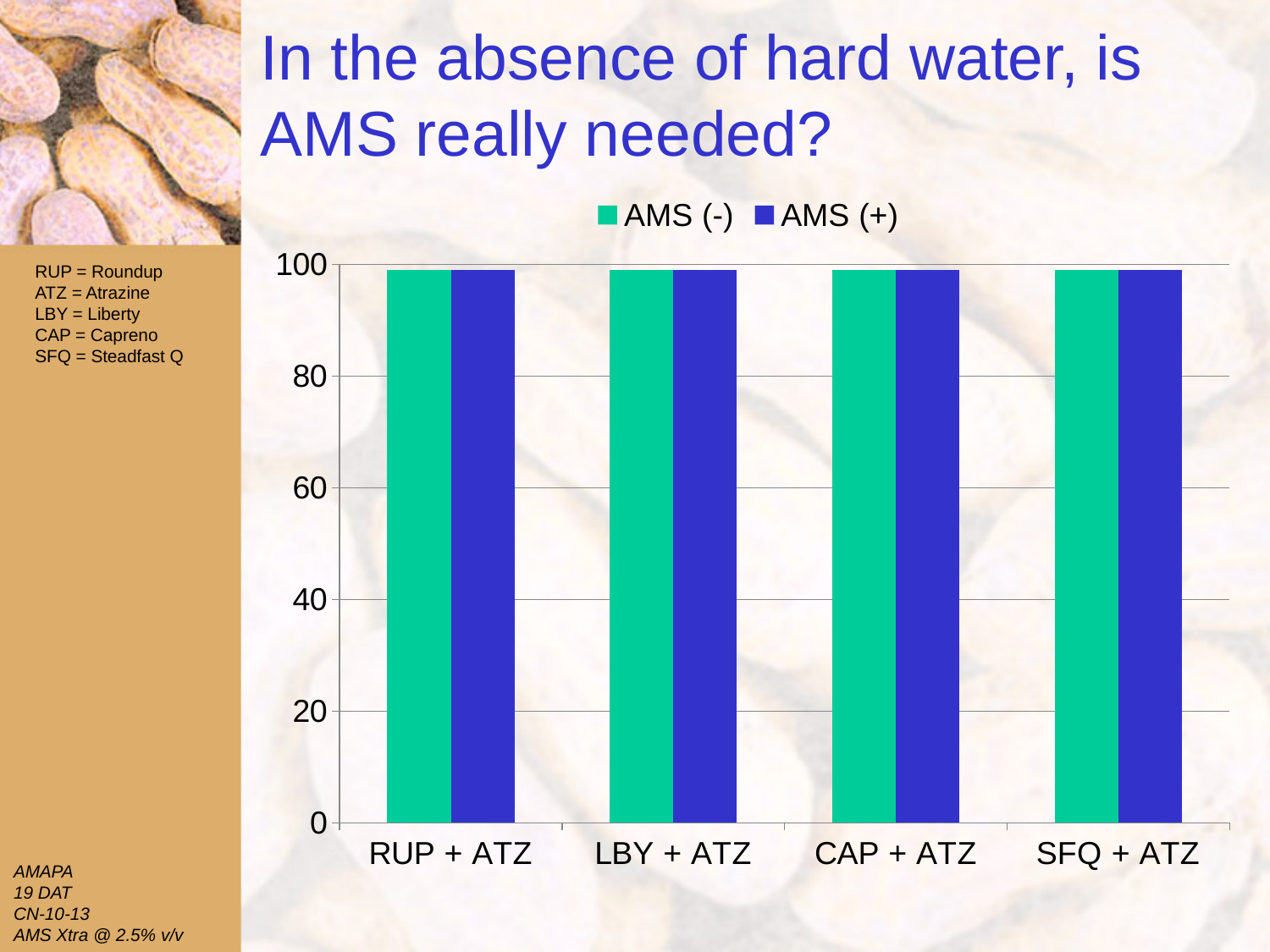
Which colour represents the AMS (+) series in the chart? blue Is the AMS (-) value for RUP + ATZ greater or less than 80? greater Is the AMS (+) value for SFQ + ATZ greater or less than 40? greater What is the highest value shown on the chart's vertical axis? 100 Is the AMS (-) value for SFQ + ATZ greater or less than 20? greater How many series does the chart's legend list? 2 How many categories are shown on the x axis of the chart? 4 What are the two series named in the chart's legend? AMS (-) and AMS (+) What kind of chart is shown on the slide? bar chart